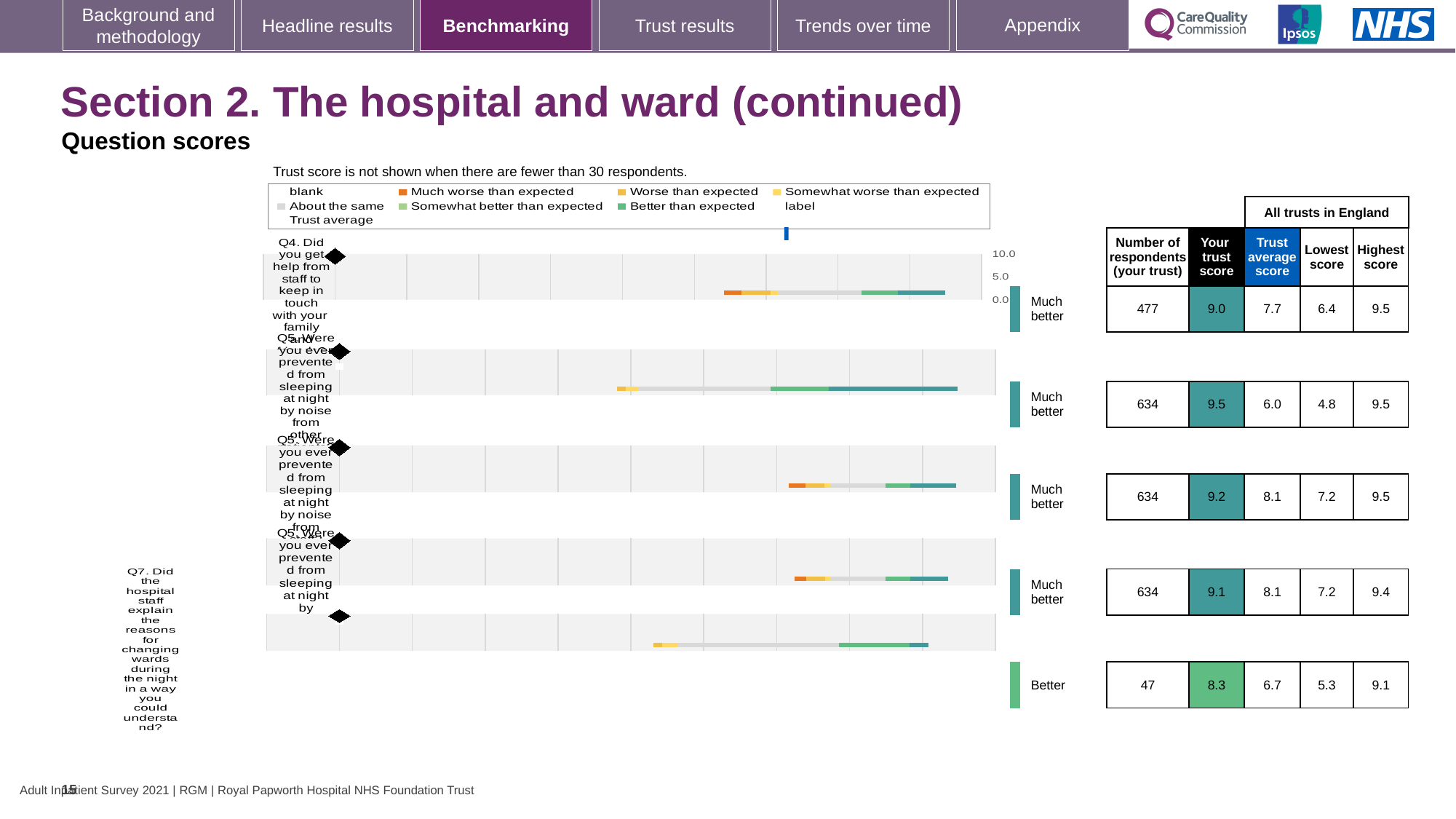
By how much does the Q4 'Your trust score' exceed the Q4 trust average score? 1.3 What is the lowest score across all trusts in England for Q7? 5.3 What is the 'Your trust score' for Q7 (explaining reasons for changing wards during the night)? 8.3 What benchmark category label is shown next to the Q7 row? Better What is the 'Your trust score' for Q4 (help from staff to keep in touch with family)? 9.0 What type of chart is used to show the question scores on this slide? bar chart Which has the higher 'Your trust score', Q4 or Q7? Q4 Which question has the fewest respondents from your trust? Q7 What is the trust average score for Q7? 6.7 How many question rows are plotted in the benchmarking chart? 5 What is the highest 'Your trust score' value shown in the table? 9.5 How many respondents from your trust answered Q4? 477